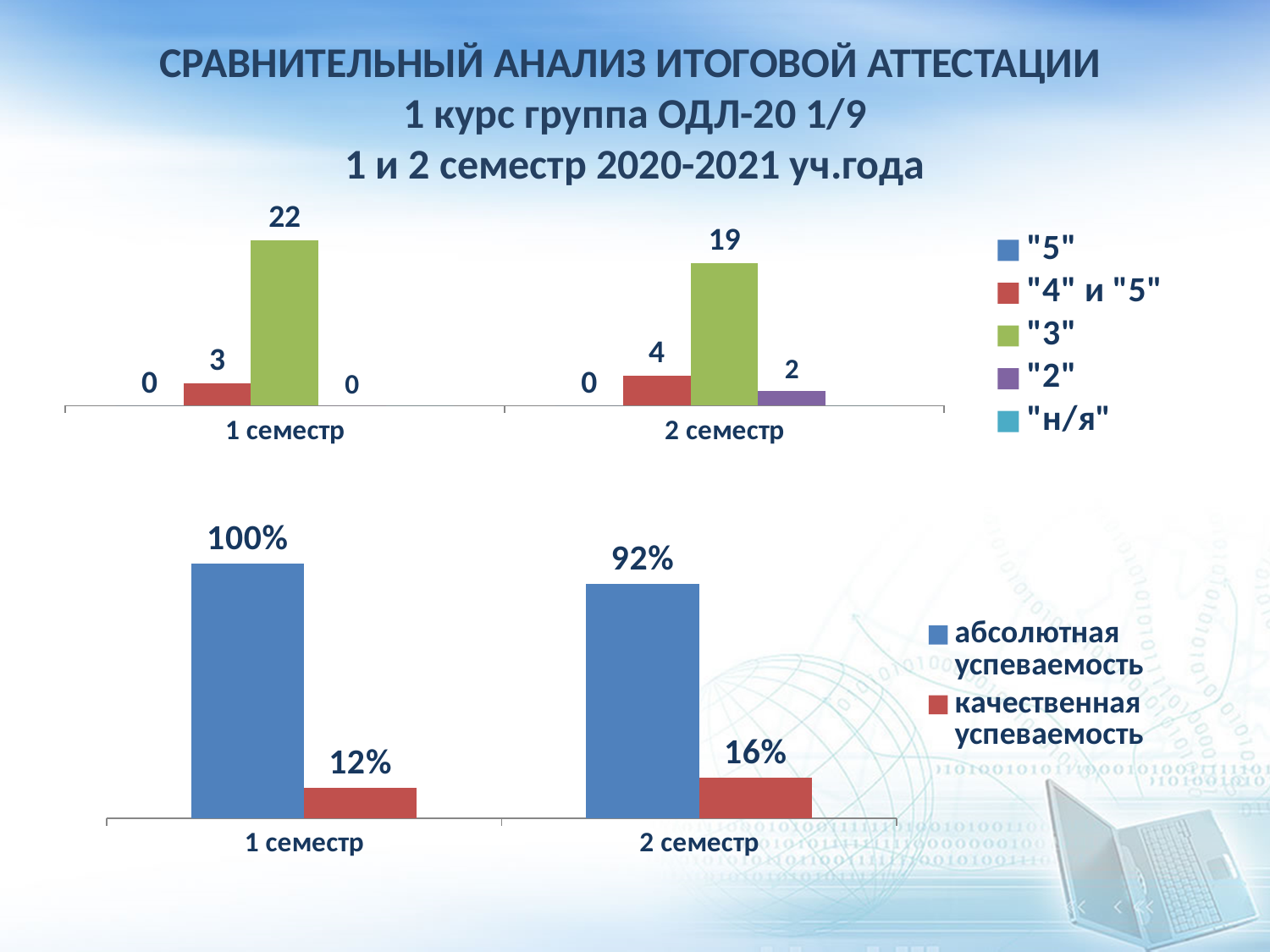
What kind of chart is the bottom chart? bar chart In the bottom chart, what is the value for абсолютная успеваемость in 2 семестр? 92% In the bottom chart, does абсолютная успеваемость rise or fall from 1 семестр to 2 семестр? fall In the top chart, what is the value for "3" in 1 семестр? 22 In the top chart, what is the value for "4" и "5" in 2 семестр? 4 In the top chart, what is the value for "3" in 2 семестр? 19 In the bottom chart, what is the difference between качественная успеваемость in 2 семестр and 1 семестр? 4% In the top chart, which series has the highest value in 1 семестр? "3" In the top chart, what is the difference between the "3" values for 1 семестр and 2 семестр? 3 In the top chart, how many series does the legend list? 5 In the bottom chart, what is the value for качественная успеваемость in 1 семестр? 12% In the top chart, what is the value for "2" in 2 семестр? 2